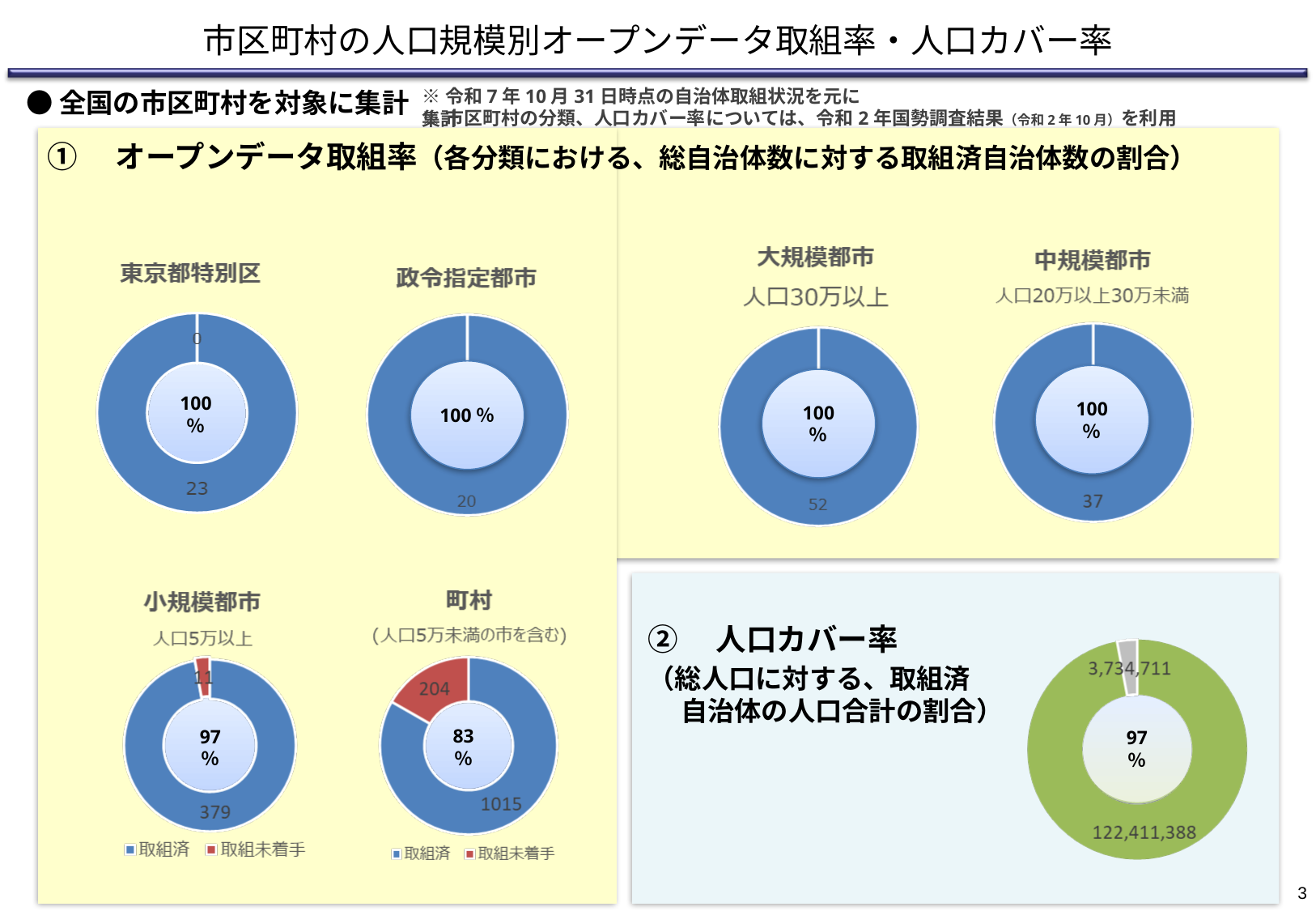
「町村」のグラフで、取組済と取組未着手を合計した自治体数はいくつですか？ 1219 ①のオープンデータ取組率のグラフのうち、取組率が最も低い分類はどれですか？ 町村 「町村」のグラフで、取組済の自治体数は取組未着手の自治体数よりいくつ多いですか？ 811 「大規模都市」のグラフで、取組済の自治体数はいくつですか？ 52 「小規模都市」のグラフで、取組済と取組未着手を合計した自治体数はいくつですか？ 390 「町村」のグラフで、取組未着手の自治体数はいくつですか？ 204 「小規模都市」のグラフで、取組済の自治体数はいくつですか？ 379 「小規模都市」のグラフの凡例には、いくつの系列が示されていますか？ 2 「町村」のオープンデータ取組率は何％ですか？ 83% 「小規模都市」と「町村」では、どちらのオープンデータ取組率が高いですか？ 小規模都市 ②「人口カバー率」のグラフで、取組済自治体の人口合計はいくつですか？ 122,411,388 ②「人口カバー率」のグラフは、どの種類のグラフですか？ 円グラフ（ドーナツグラフ）